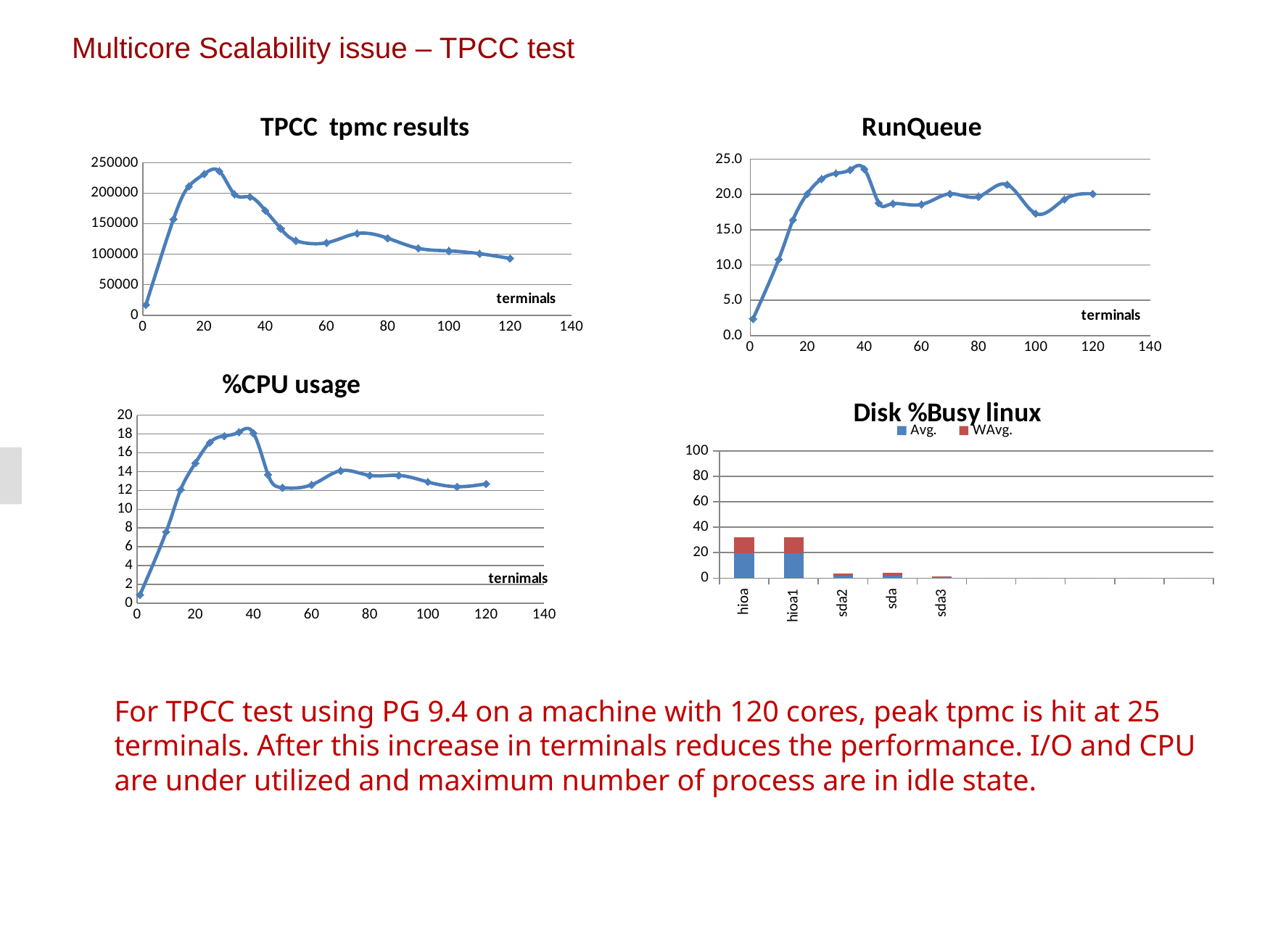
In the TPCC tpmc results chart, do the values rise or fall between 40 and 120 terminals? fall In the Disk %Busy linux chart, how many disk categories are shown on the x axis? 5 In the Disk %Busy linux chart, how many series does the legend list? 2 What kind of chart is the Disk %Busy linux chart? bar chart In the Disk %Busy linux chart, which disk has the lowest total bar? sda3 What kind of chart is the TPCC tpmc results chart? line chart In the Disk %Busy linux chart, what are the two legend entries? Avg. and WAvg. In the %CPU usage chart, is the value at 10 terminals greater or less than 10? less In the TPCC tpmc results chart, is the value at 20 terminals greater or less than 150000? greater In the TPCC tpmc results chart, is the value at 120 terminals greater or less than 100000? less